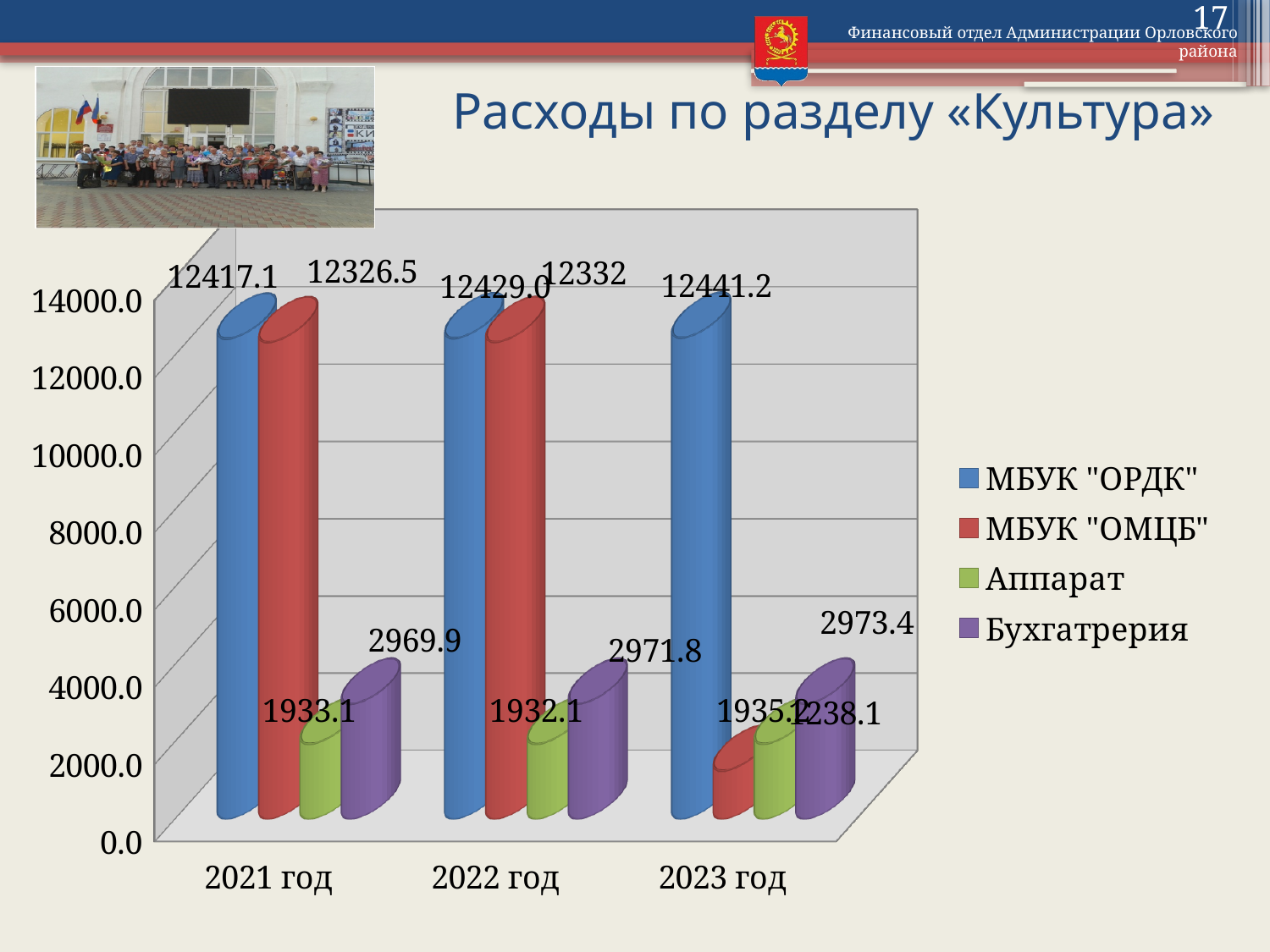
What is the value for Бухгатрерия in 2023 год? 2973.4 In which year is the value for МБУК "ОРДК" the highest? 2023 год What is the value for МБУК "ОРДК" in 2021 год? 12417.1 What type of chart is shown on the slide? bar chart How many series does the legend list? 4 What is the difference between МБУК "ОРДК" and МБУК "ОМЦБ" in 2021 год? 90.6 Is the value for МБУК "ОМЦБ" in 2023 год greater or less than 4000.0? less How many year categories are shown on the x axis? 3 What is the title of the chart? Расходы по разделу «Культура» What is the value for МБУК "ОМЦБ" in 2022 год? 12332 Which is larger in 2022 год: Бухгатрерия or Аппарат? Бухгатрерия What is the value for Аппарат in 2021 год? 1933.1